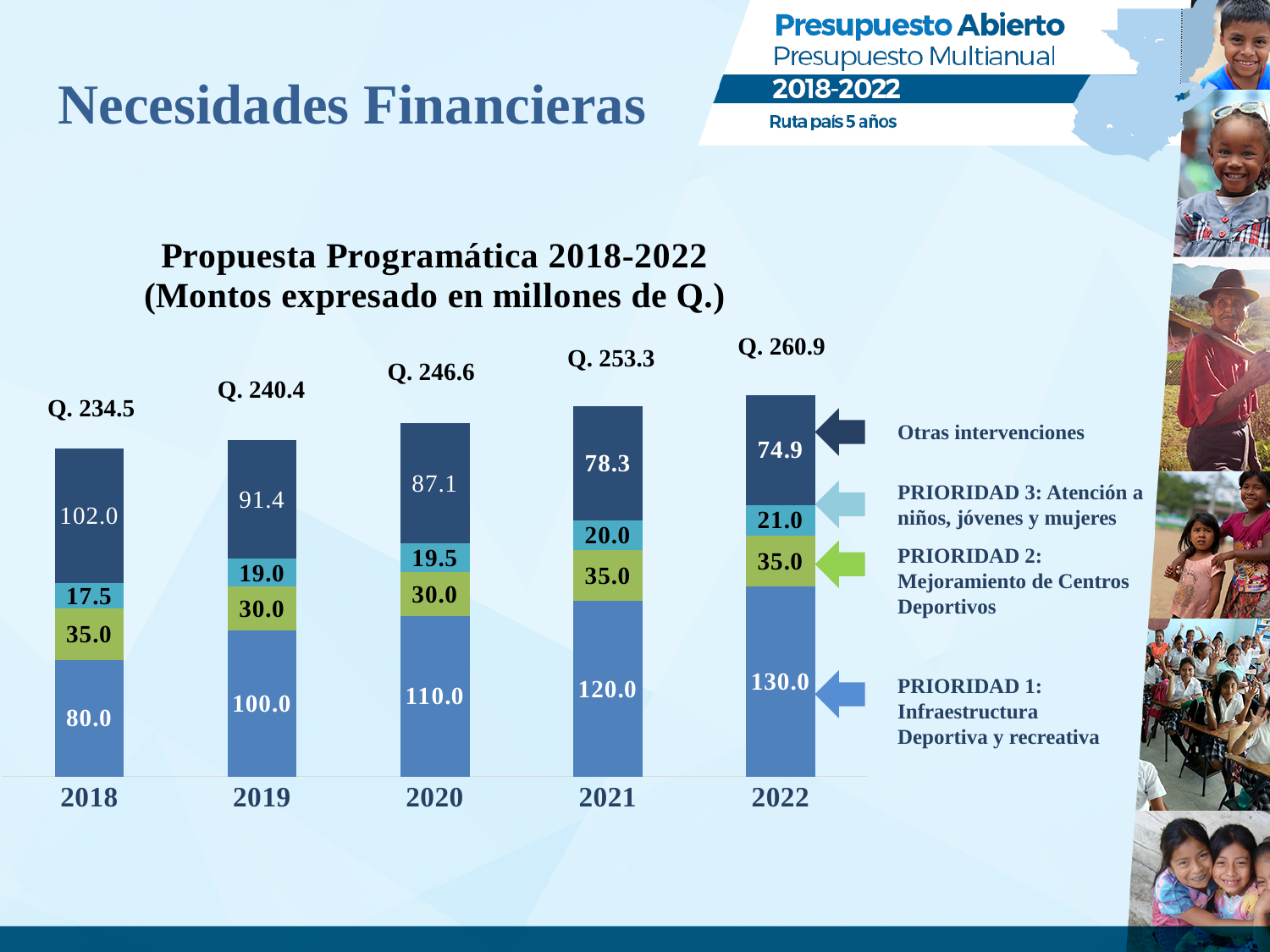
What is the difference between the PRIORIDAD 1 value in 2022 and in 2018? 50.0 What kind of chart is shown? Stacked bar chart How many years are shown on the x axis? 5 What is the value for Otras intervenciones in 2020? 87.1 How many series does the legend list? 4 Which is larger: Otras intervenciones in 2018 or in 2022? 2018 What is the total of the stacked bar for 2021? Q. 253.3 Do the values for Otras intervenciones rise or fall from 2018 to 2022? Fall Which year has the highest total? 2022 What is the value for PRIORIDAD 1: Infraestructura Deportiva y recreativa in 2018? 80.0 Which year has the lowest value for PRIORIDAD 1: Infraestructura Deportiva y recreativa? 2018 What is the value for PRIORIDAD 3: Atención a niños, jóvenes y mujeres in 2022? 21.0